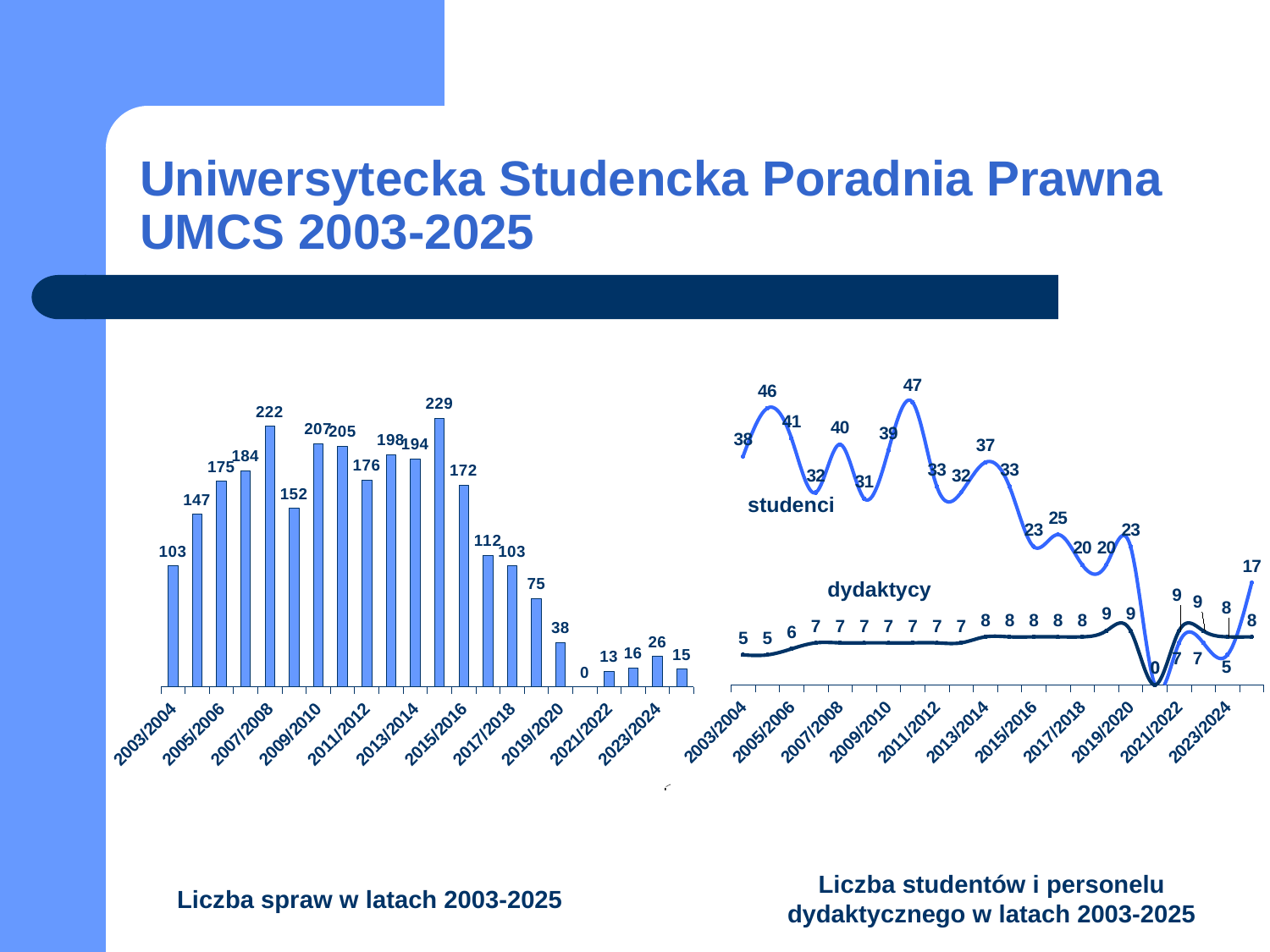
In the chart 'Liczba spraw w latach 2003-2025', what is the difference between the values for 2007/2008 and 2003/2004? 119 In the chart 'Liczba studentów i personelu dydaktycznego w latach 2003-2025', what is the value of the 'studenci' series for 2003/2004? 38 How many bars are plotted in the chart 'Liczba spraw w latach 2003-2025'? 22 In the chart 'Liczba studentów i personelu dydaktycznego w latach 2003-2025', what is the value of the 'dydaktycy' series for 2007/2008? 7 In the chart 'Liczba spraw w latach 2003-2025', what is the value for 2007/2008? 222 What kind of chart is 'Liczba spraw w latach 2003-2025'? Bar chart How many series are plotted in the chart 'Liczba studentów i personelu dydaktycznego w latach 2003-2025'? 2 In the chart 'Liczba spraw w latach 2003-2025', what is the lowest value shown? 0 In the chart 'Liczba studentów i personelu dydaktycznego w latach 2003-2025', what is the highest value of the 'studenci' series? 47 In the chart 'Liczba spraw w latach 2003-2025', which has the larger value, 2005/2006 or 2007/2008? 2007/2008 In the chart 'Liczba spraw w latach 2003-2025', what is the value for 2019/2020? 38 In the chart 'Liczba spraw w latach 2003-2025', what is the highest value shown? 229